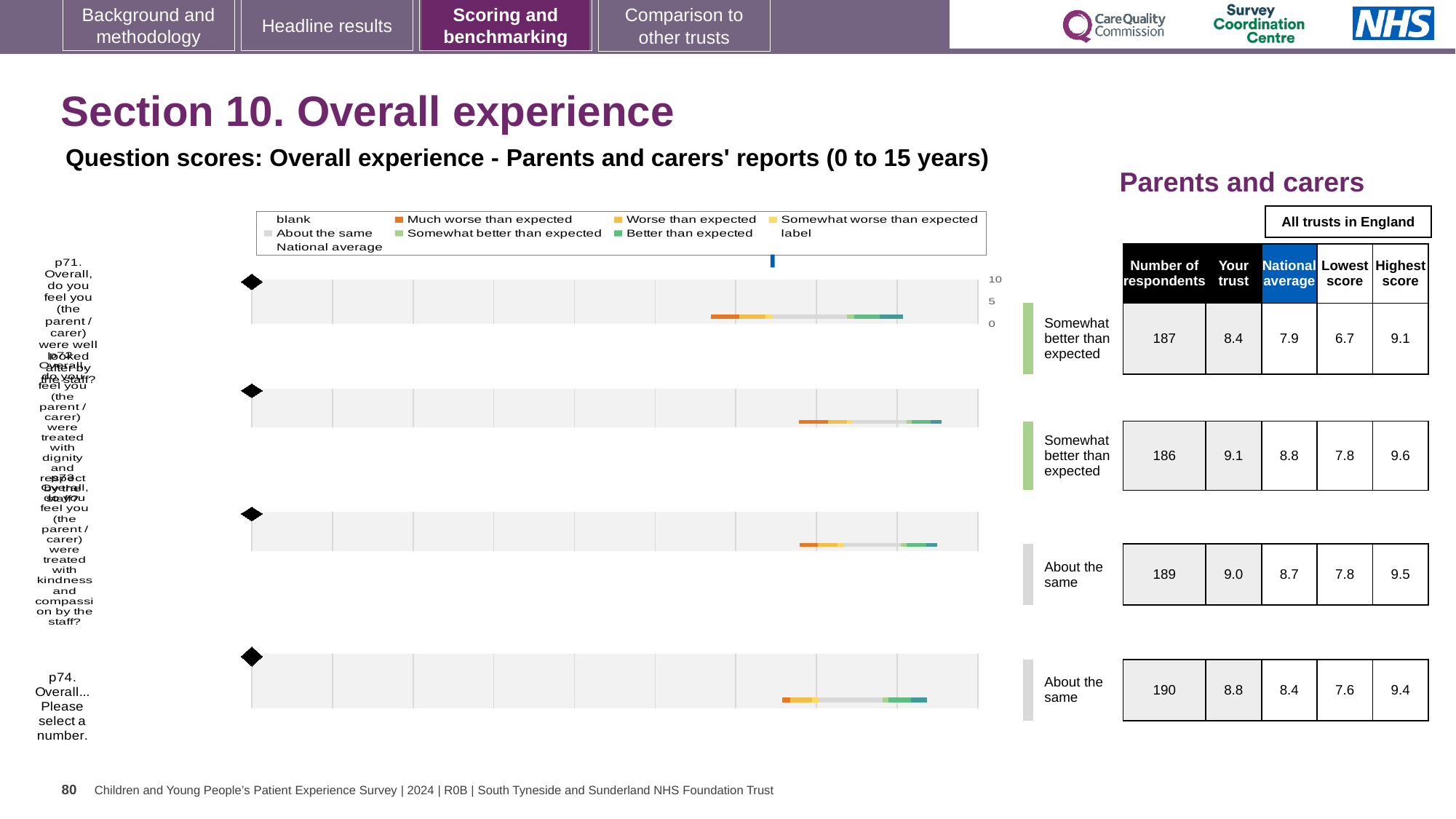
What is the 'Your trust' score for the last chart row (p74, Overall... Please select a number)? 8.8 What is the lowest number of respondents among the four chart rows? 186 What is the 'Your trust' score for the first chart row (p71, were you well looked after by the staff)? 8.4 For the first chart row (p71), what is the difference between the 'Your trust' score and the national average? 0.5 What is the highest 'Your trust' score among the four chart rows? 9.1 How many respondents answered the last chart row (p74)? 190 Which benchmark category is shown for the last chart row (p74)? About the same What kind of chart is used to show the question scores on this slide? bar chart For the last chart row (p74), which is larger: the 'Your trust' score or the national average? Your trust What is the national average for the first chart row (p71)? 7.9 How many question rows (p71 to p74) are plotted in the chart? 4 Which benchmark category is shown for the first chart row (p71)? Somewhat better than expected